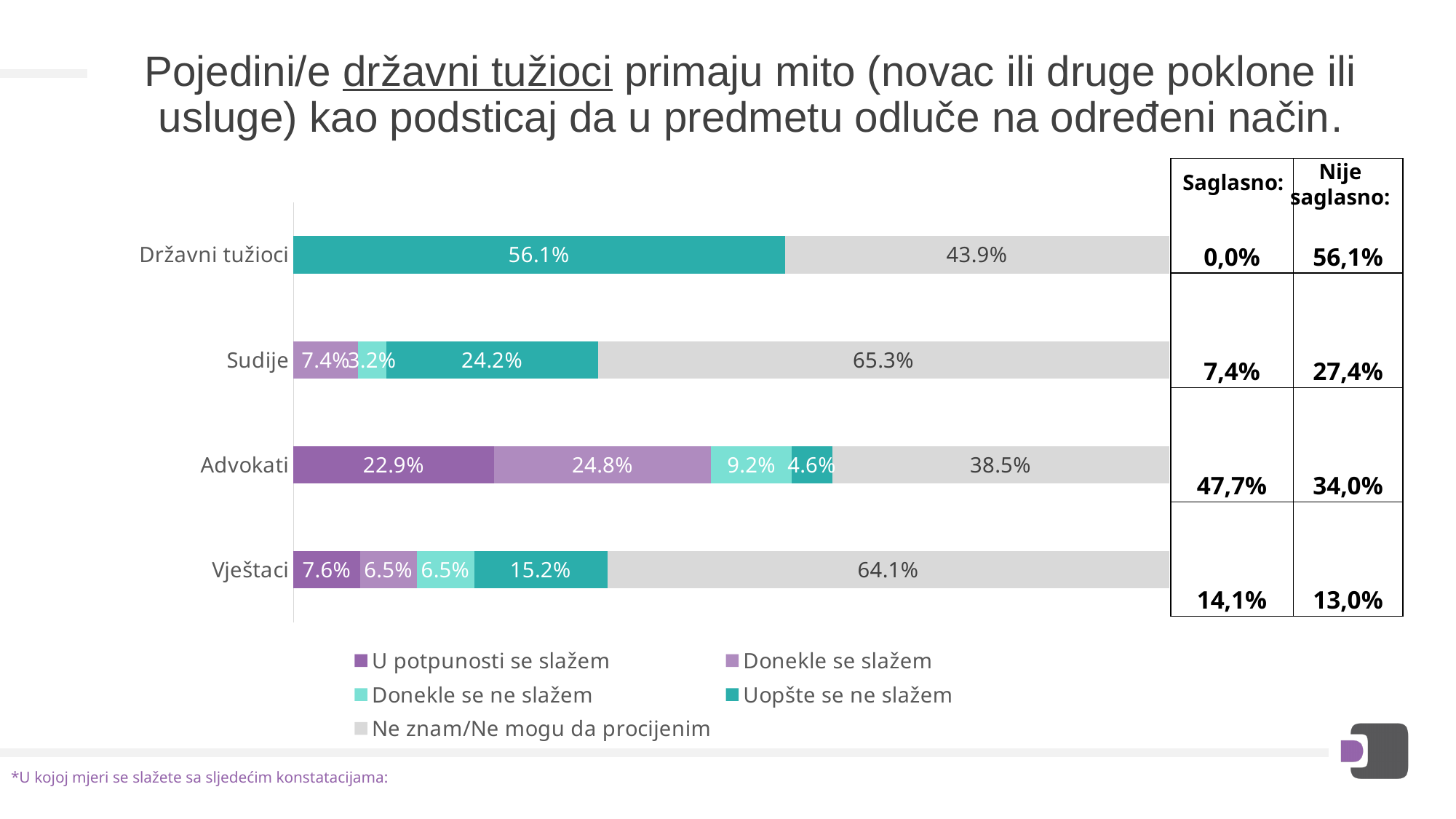
What is the value of 'U potpunosti se slažem' for Advokati? 22.9% What kind of chart is shown on the slide? Stacked bar chart What is the value of 'Ne znam/Ne mogu da procijenim' for Sudije? 65.3% What is the value of 'Uopšte se ne slažem' for Državni tužioci? 56.1% Which group has the lowest 'Ne znam/Ne mogu da procijenim' value? Advokati Which group has a larger 'Uopšte se ne slažem' value, Sudije or Vještaci? Sudije What is the value of 'Ne znam/Ne mogu da procijenim' for Vještaci? 64.1% What is the total of the two segments in the Državni tužioci bar? 100% For Advokati, what is the difference between 'Donekle se slažem' and 'U potpunosti se slažem'? 1.9 percentage points How many series does the chart legend list? 5 How many respondent groups (categories) are shown on the chart? 4 Which group has the highest 'Ne znam/Ne mogu da procijenim' value? Sudije